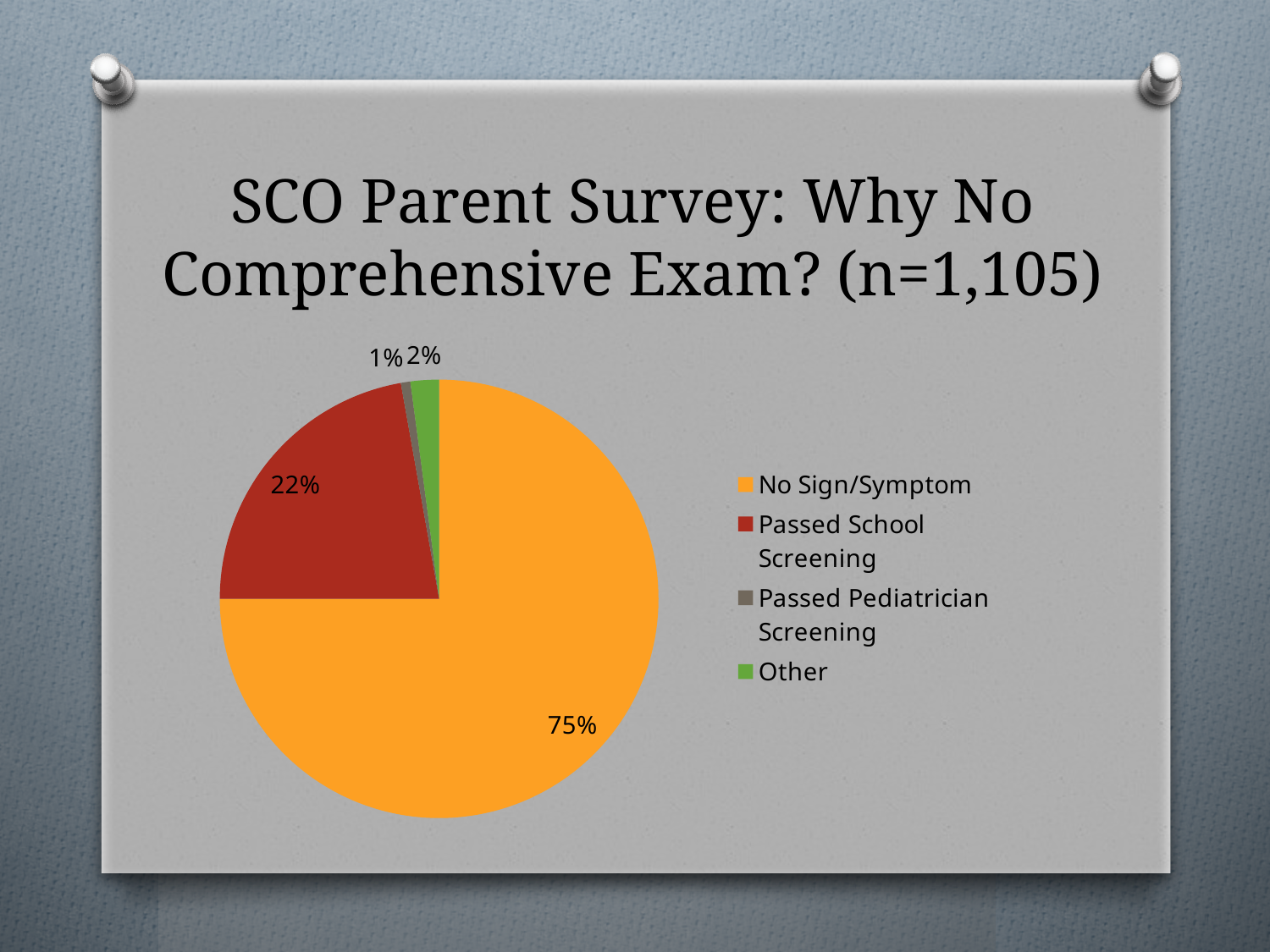
Which is larger, the share for Other or the share for Passed Pediatrician Screening? Other Which category has the largest slice of the pie? No Sign/Symptom What colour is the slice for Passed School Screening? red What is the title of the chart on the slide? SCO Parent Survey: Why No Comprehensive Exam? (n=1,105) What share of the pie is Passed Pediatrician Screening? 1% What share of the pie is Other? 2% How many categories does the legend list? 4 What kind of chart is shown on the slide? pie chart What share of the pie is Passed School Screening? 22% What is the difference in percentage points between No Sign/Symptom and Passed School Screening? 53 Which category has the smallest slice of the pie? Passed Pediatrician Screening